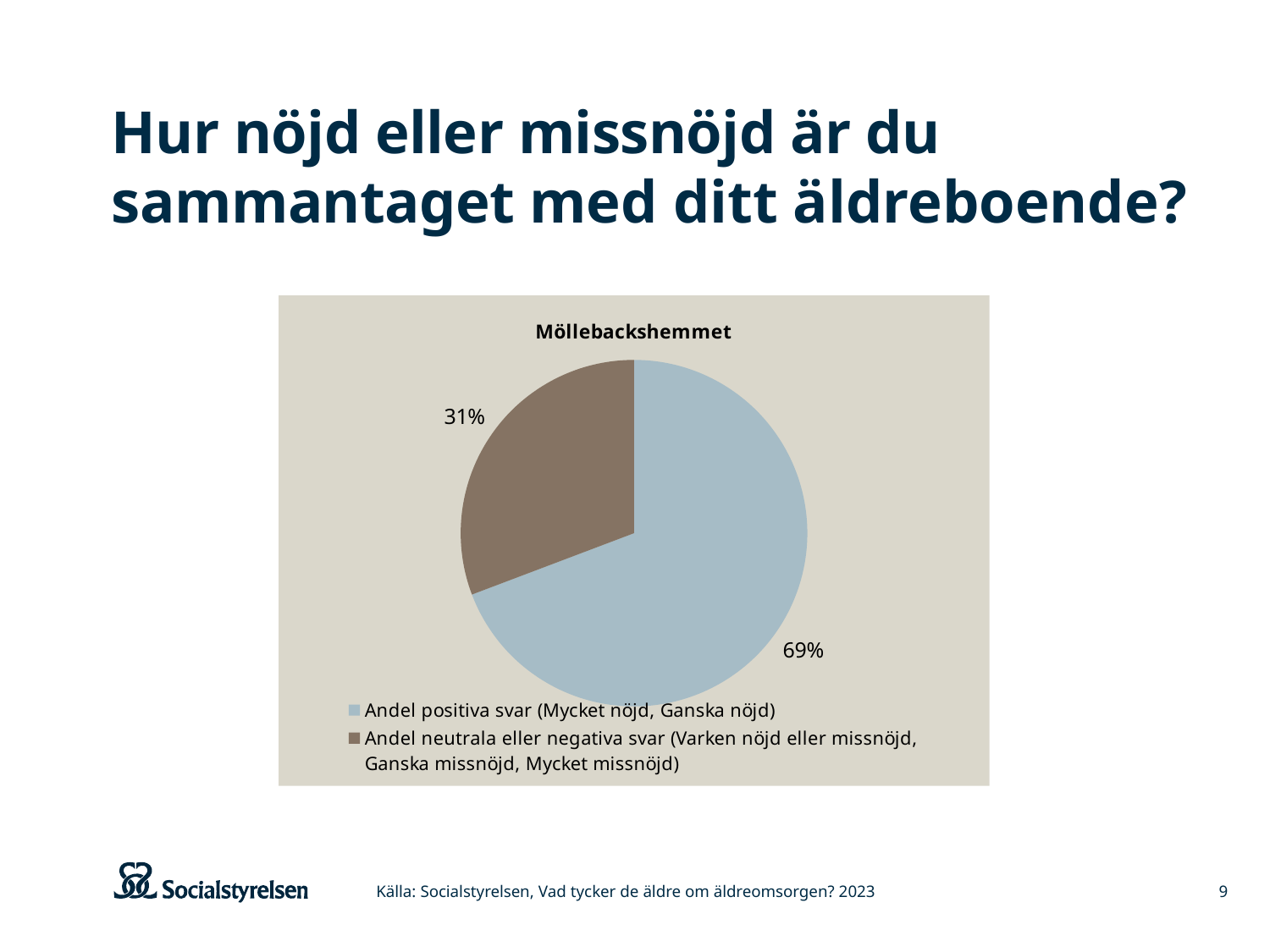
What is the difference in percentage points between the positive slice and the neutral/negative slice? 38 percentage points Is the share of positive answers greater or less than 50%? greater What is the title of the chart? Möllebackshemmet What share of the pie is 'Andel neutrala eller negativa svar (Varken nöjd eller missnöjd, Ganska missnöjd, Mycket missnöjd)'? 31% What share of the pie is 'Andel positiva svar (Mycket nöjd, Ganska nöjd)'? 69% What type of chart is shown on the slide? Pie chart Which slice is the smallest in the pie chart? Andel neutrala eller negativa svar (Varken nöjd eller missnöjd, Ganska missnöjd, Mycket missnöjd) Which is larger: the share of positive answers or the share of neutral or negative answers? Andel positiva svar (Mycket nöjd, Ganska nöjd) How many slices does the pie chart have? 2 How many entries does the legend list? 2 Which slice is the largest in the pie chart? Andel positiva svar (Mycket nöjd, Ganska nöjd) What colour is the slice for 'Andel positiva svar (Mycket nöjd, Ganska nöjd)'? Light blue